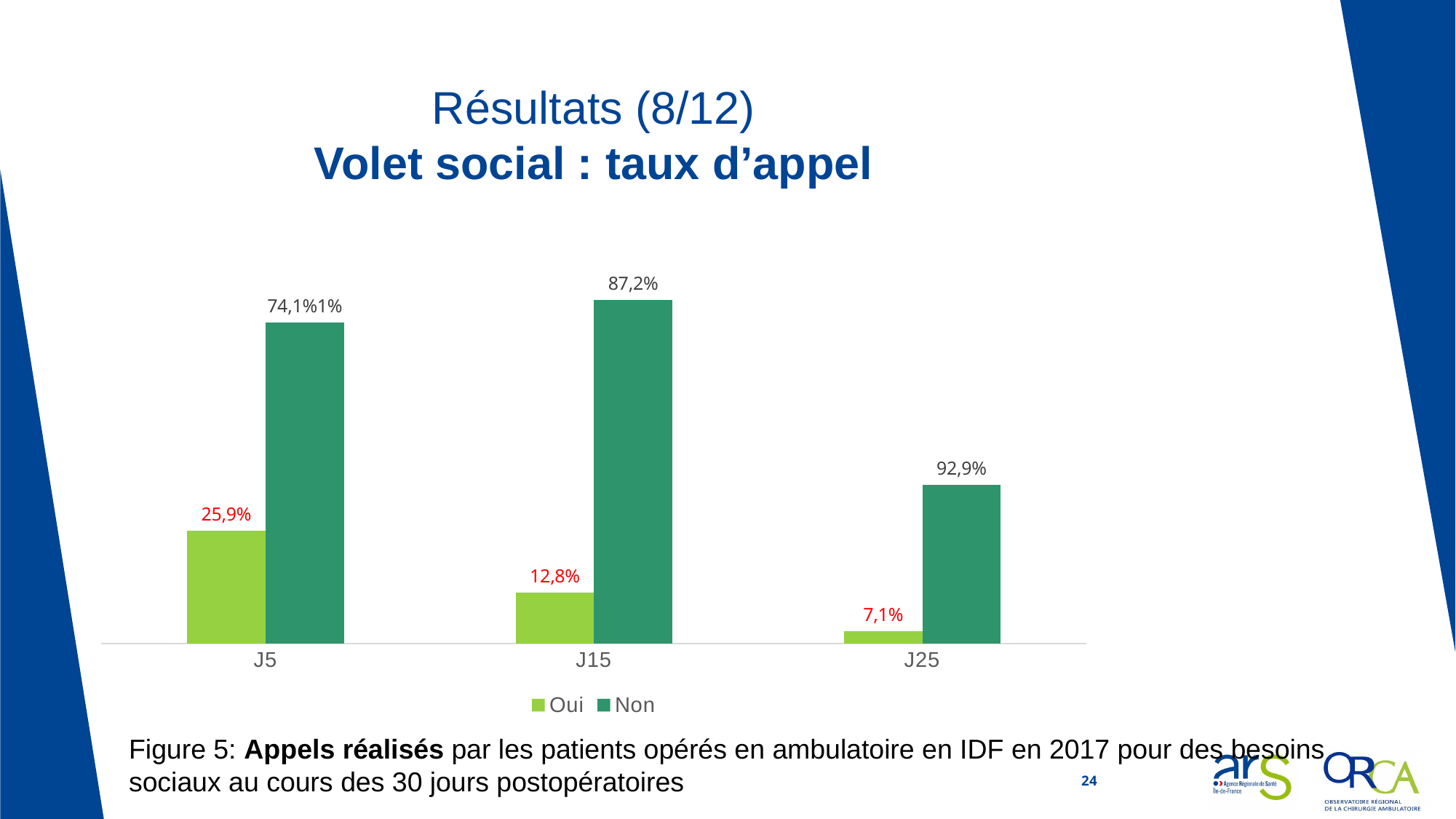
How many series does the legend list? 2 What is the value of the Non series for J15? 87,2% What is the value of the Oui series for J15? 12,8% How many categories are shown on the x axis? 3 What is the value of the Oui series for J5? 25,9% Which category has the lowest value for the Oui series? J25 What is the difference between the Oui values for J5 and J15? 13,1% What is the difference between the Non values for J25 and J15? 5,7% For J5, which series has the larger value, Oui or Non? Non Do the Oui values rise or fall from J5 to J25? fall What is the value of the Non series for J25? 92,9%